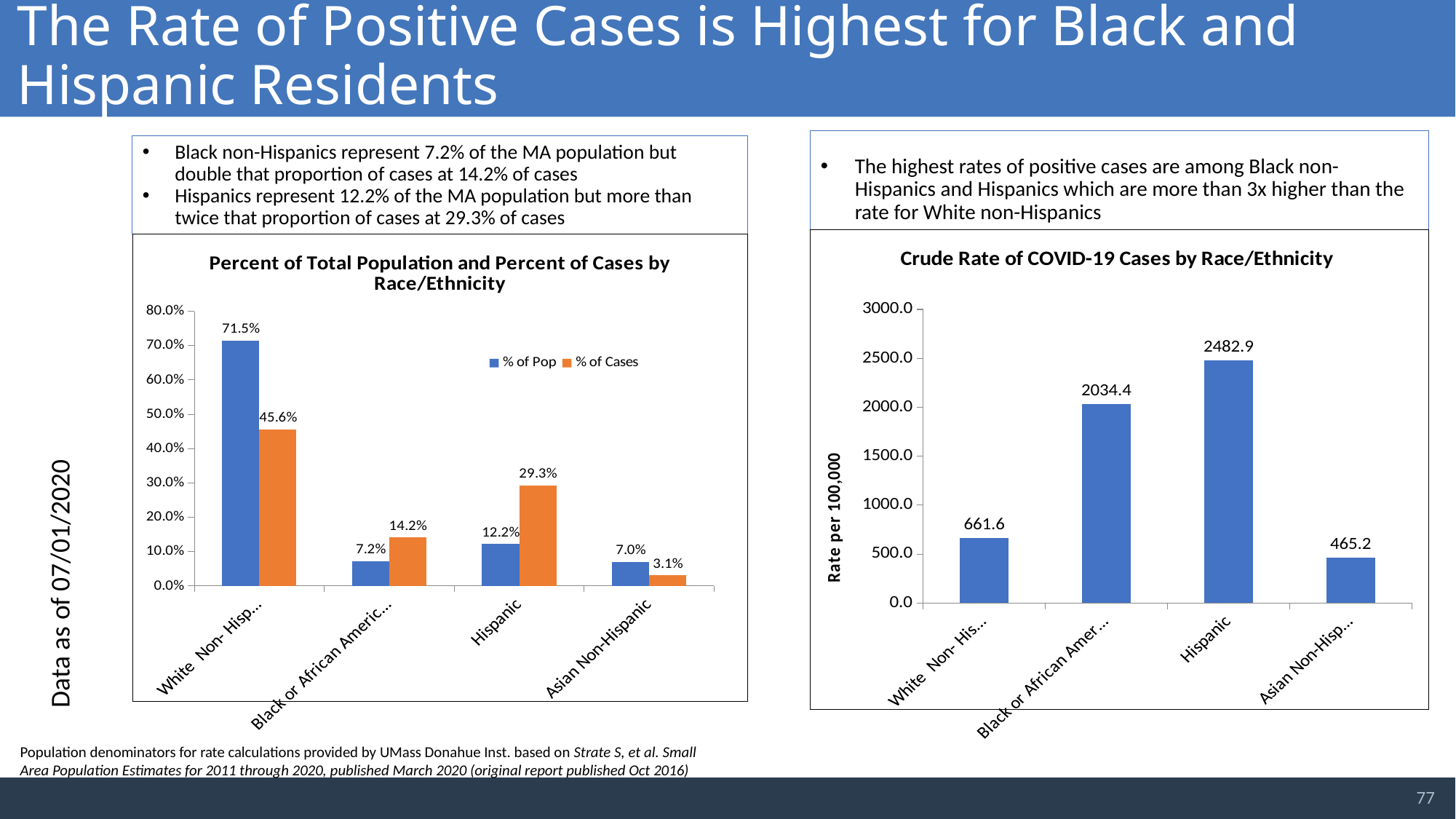
In the 'Percent of Total Population and Percent of Cases by Race/Ethnicity' chart, what is the % of Cases for Hispanic? 29.3% What type of chart is the 'Crude Rate of COVID-19 Cases by Race/Ethnicity' chart? Bar chart In the 'Crude Rate of COVID-19 Cases by Race/Ethnicity' chart, which category has the highest rate? Hispanic In the 'Percent of Total Population and Percent of Cases by Race/Ethnicity' chart, what is the % of Pop for Asian Non-Hispanic? 7.0% In the 'Crude Rate of COVID-19 Cases by Race/Ethnicity' chart, what is the rate for Asian Non-Hispanic? 465.2 In the 'Crude Rate of COVID-19 Cases by Race/Ethnicity' chart, which category has the lowest rate? Asian Non-Hispanic How many series does the legend of the 'Percent of Total Population and Percent of Cases by Race/Ethnicity' chart list? 2 In the 'Crude Rate of COVID-19 Cases by Race/Ethnicity' chart, what is the difference between the Hispanic rate and the Asian Non-Hispanic rate? 2017.7 In the 'Percent of Total Population and Percent of Cases by Race/Ethnicity' chart, which is larger for Hispanic: % of Pop or % of Cases? % of Cases In the 'Crude Rate of COVID-19 Cases by Race/Ethnicity' chart, how many categories are shown? 4 In the 'Percent of Total Population and Percent of Cases by Race/Ethnicity' chart, what is the difference between % of Cases and % of Pop for Hispanic? 17.1% In the 'Crude Rate of COVID-19 Cases by Race/Ethnicity' chart, what is the rate for Hispanic? 2482.9